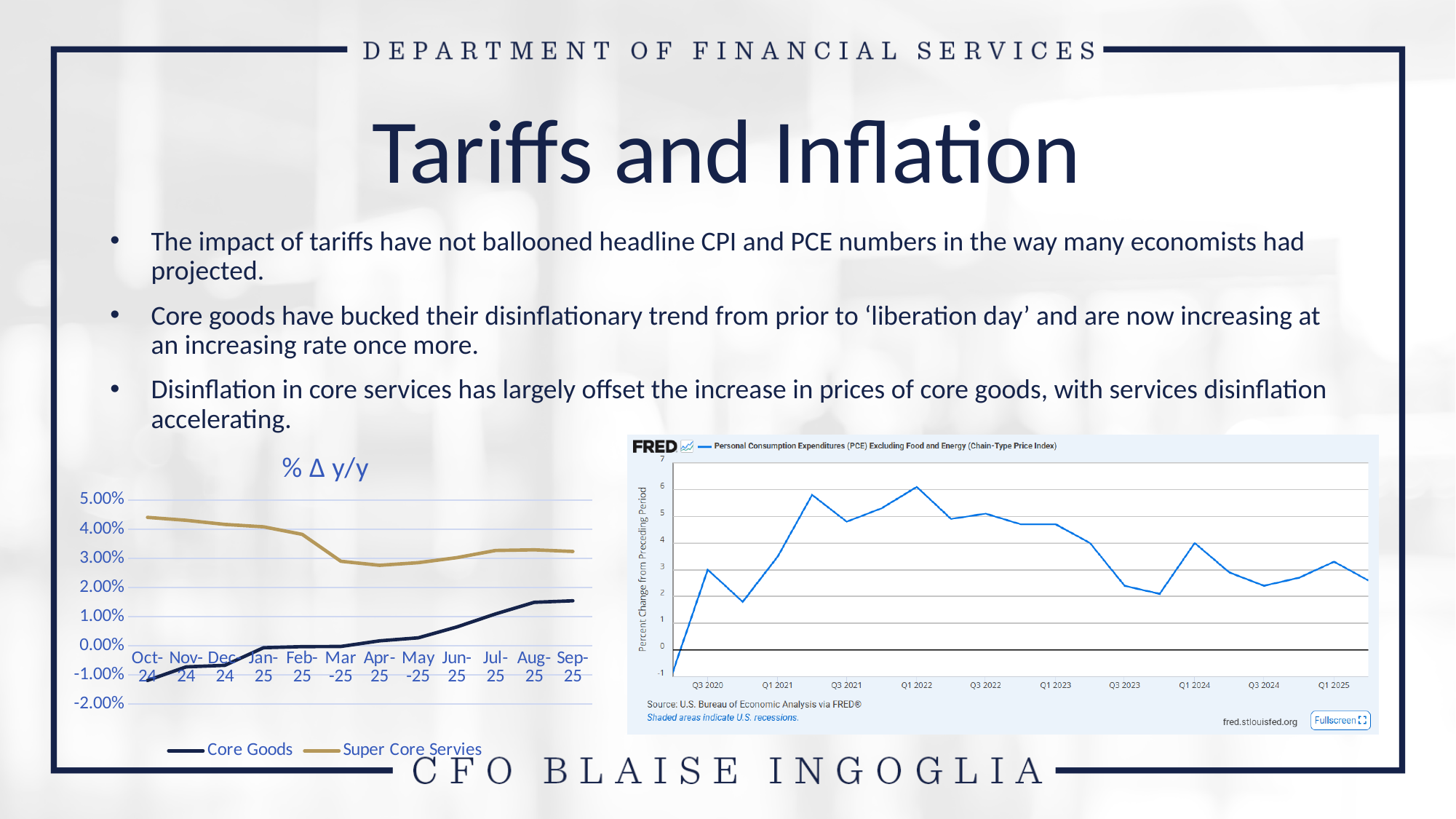
In the '% Δ y/y' chart, is the Core Goods value for Oct-24 greater or less than 0.00%? less In the '% Δ y/y' chart, does the Super Core Servies line rise or fall from Oct-24 to Sep-25? Falls What kind of chart is the '% Δ y/y' chart on the left of the slide? Line chart In the '% Δ y/y' chart, in which month is the Super Core Servies line at its highest? Oct-24 In the FRED chart on the right, around which quarter does the PCE excluding food and energy line reach its peak? Q1 2022 In the '% Δ y/y' chart, is the Super Core Servies value for Oct-24 greater or less than 4.00%? greater What are the two series named in the legend of the '% Δ y/y' chart? Core Goods and Super Core Servies How many months are plotted along the x axis of the '% Δ y/y' chart? 12 In the '% Δ y/y' chart, does the Core Goods line rise or fall from Oct-24 to Sep-25? Rises In the '% Δ y/y' chart, which series has the higher value in Sep-25, Core Goods or Super Core Servies? Super Core Servies How many series does the legend of the '% Δ y/y' chart list? 2 What kind of chart is the FRED chart on the right of the slide? Line chart